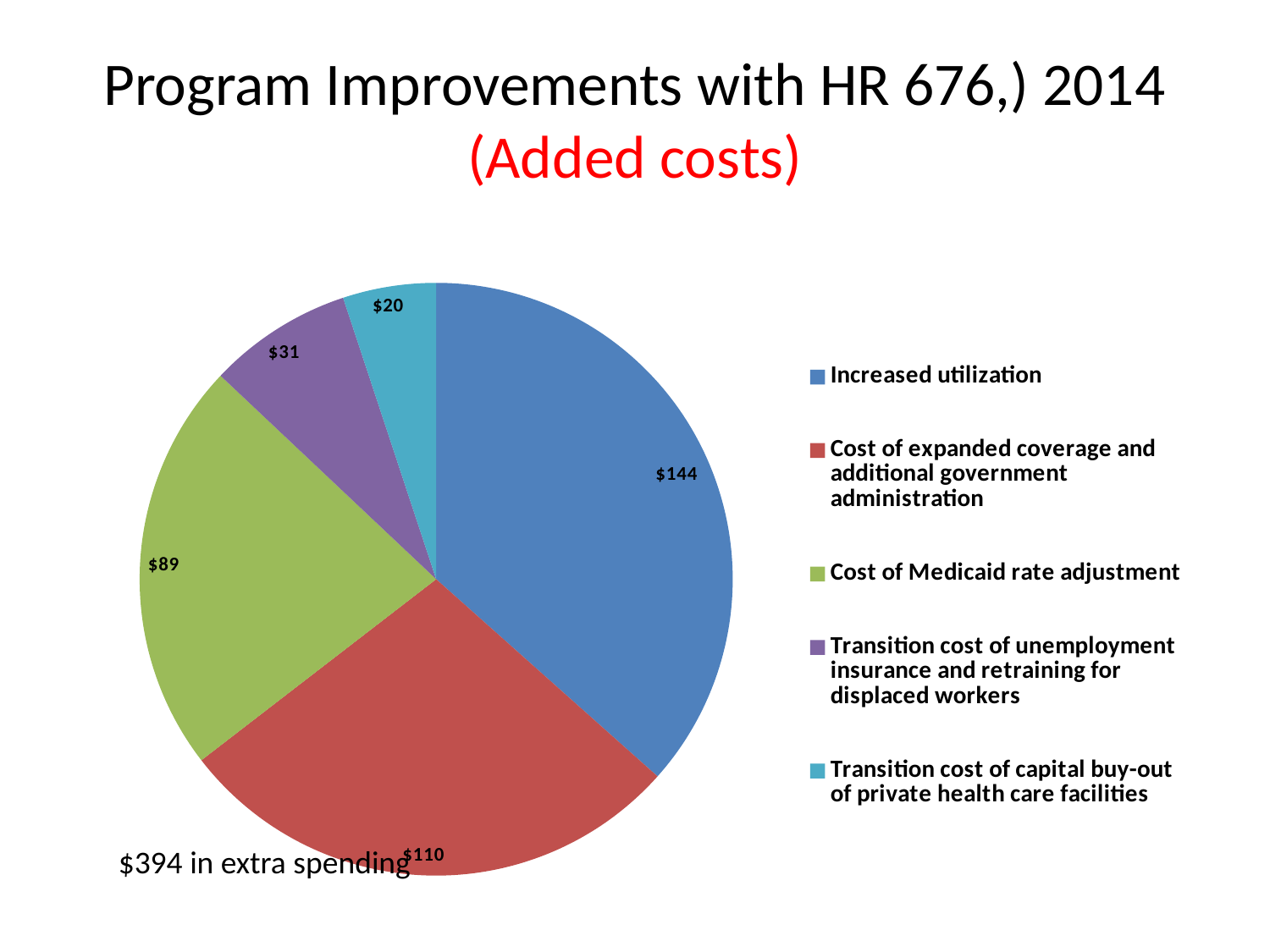
How many slices does the pie chart have? 5 Which is larger: Cost of Medicaid rate adjustment or Transition cost of unemployment insurance and retraining for displaced workers? Cost of Medicaid rate adjustment What colour is the slice for Cost of Medicaid rate adjustment? Green What is the value for Increased utilization? $144 What is the total of all the slices in the pie chart? $394 What type of chart is shown on the slide? Pie chart What is the value for Cost of expanded coverage and additional government administration? $110 Which category has the smallest slice of the pie? Transition cost of capital buy-out of private health care facilities Which category has the largest slice of the pie? Increased utilization What is the difference between Increased utilization and Cost of expanded coverage and additional government administration? $34 What is the value for Cost of Medicaid rate adjustment? $89 What is the value for Transition cost of capital buy-out of private health care facilities? $20